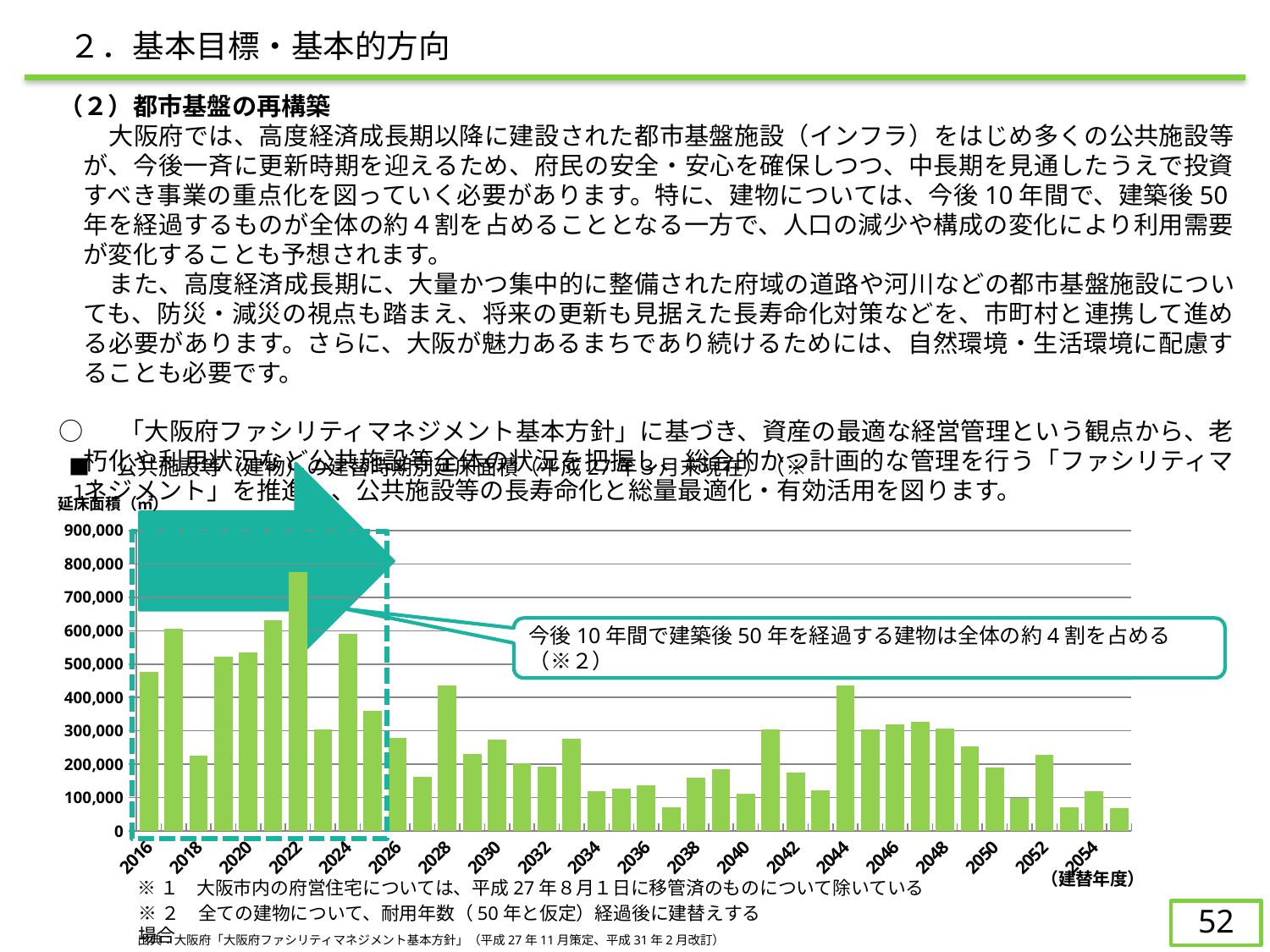
What kind of chart is shown on the slide? bar chart Is the value for 2044 greater or less than 300,000? greater Which has the larger value, 2016 or 2018? 2016 Which rebuild year (建替年度) has the highest floor area in the chart? 2022 Is the value for 2034 greater or less than 200,000? less What is the label on the vertical axis of the chart? 延床面積（㎡） Is the value for 2022 greater or less than 700,000? greater Which has the larger value, 2022 or 2028? 2022 What is the highest tick value shown on the vertical axis? 900,000